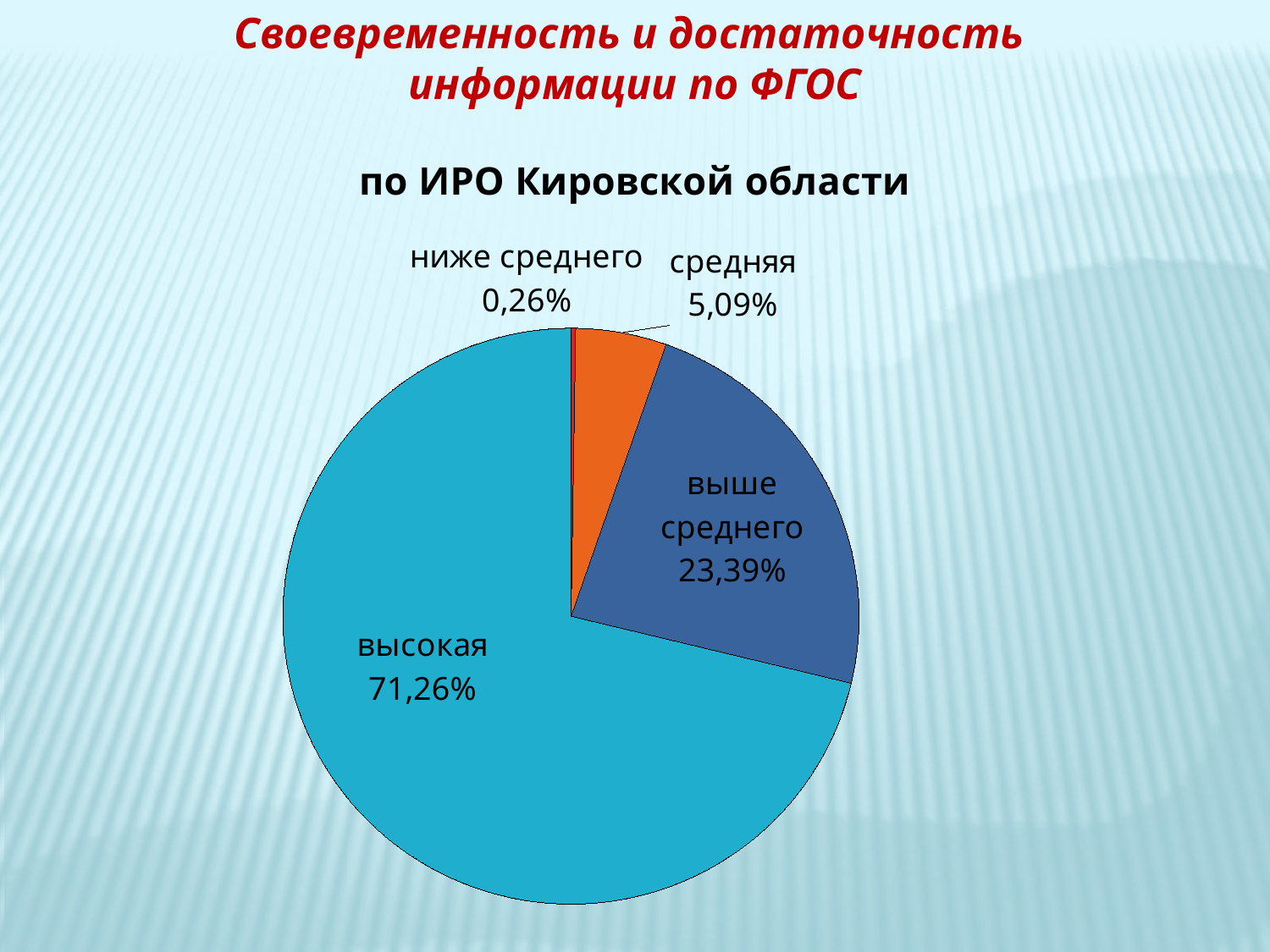
What percentage is shown for the slice "средняя"? 5,09% How many slices does the pie chart have? 4 Which is larger, the share for "средняя" or the share for "выше среднего"? выше среднего What is the title of the chart? по ИРО Кировской области What colour is the slice for "средняя"? orange What is the difference in percentage points between "высокая" and "выше среднего"? 47,87 What percentage is shown for the slice "высокая"? 71,26% What percentage is shown for the slice "ниже среднего"? 0,26% What type of chart is shown on the slide? pie chart Which slice of the pie chart is the largest? высокая What percentage is shown for the slice "выше среднего"? 23,39% Which slice of the pie chart is the smallest? ниже среднего